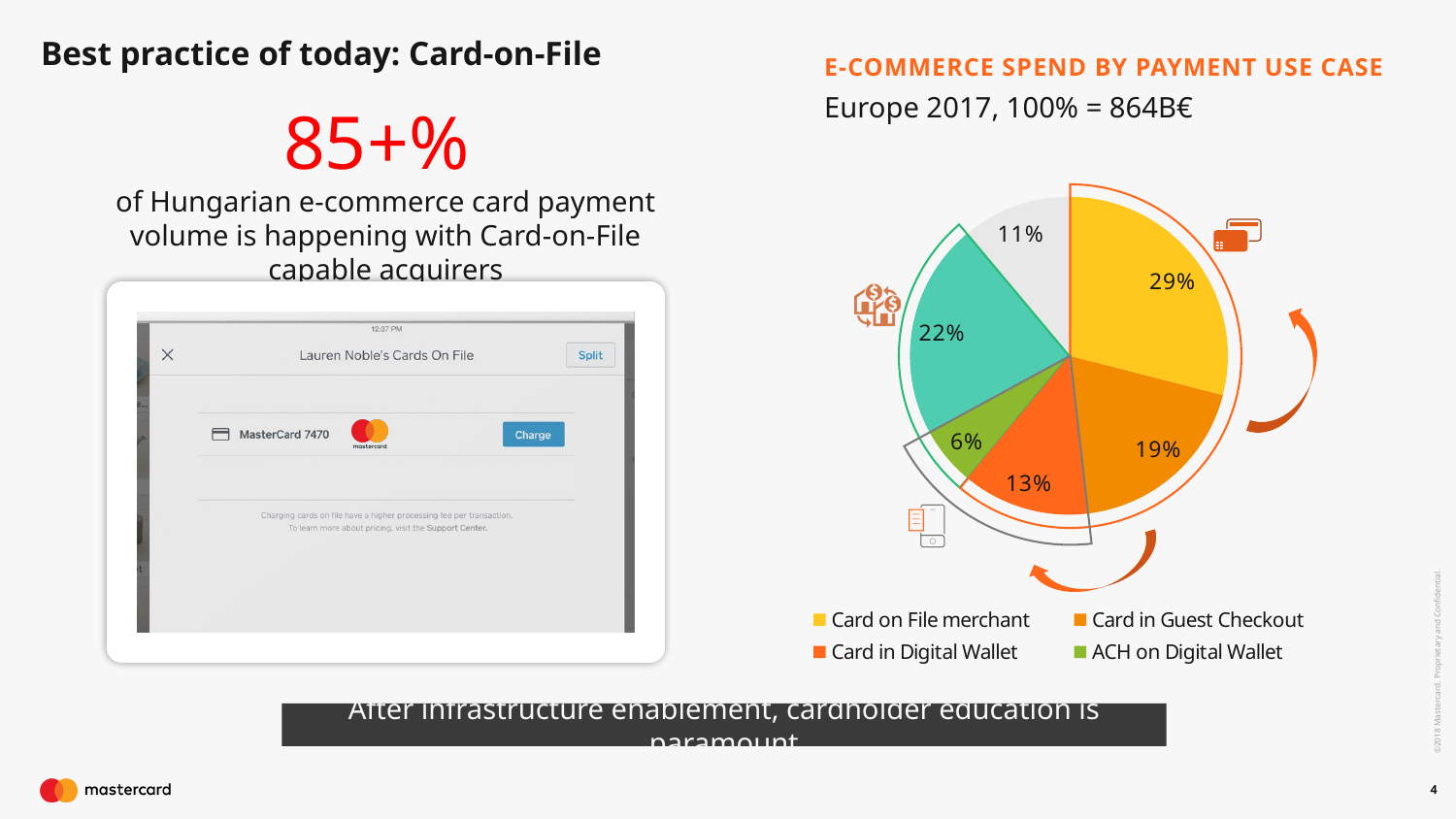
Which is larger, the slice for Card in Digital Wallet or the slice for ACH on Digital Wallet? Card in Digital Wallet What share of the pie does Card on File merchant represent? 29% What share of the pie does ACH on Digital Wallet represent? 6% What type of chart is shown on the slide? pie chart What is the difference in percentage points between Card on File merchant and Card in Guest Checkout? 10 What share of the pie does Card in Guest Checkout represent? 19% What is the title of the chart on the slide? E-COMMERCE SPEND BY PAYMENT USE CASE Which legend category has the smallest slice of the pie? ACH on Digital Wallet Which legend category has the largest slice of the pie? Card on File merchant What share of the pie does Card in Digital Wallet represent? 13% How many entries does the chart legend list? 4 How many slices does the pie chart have? 6